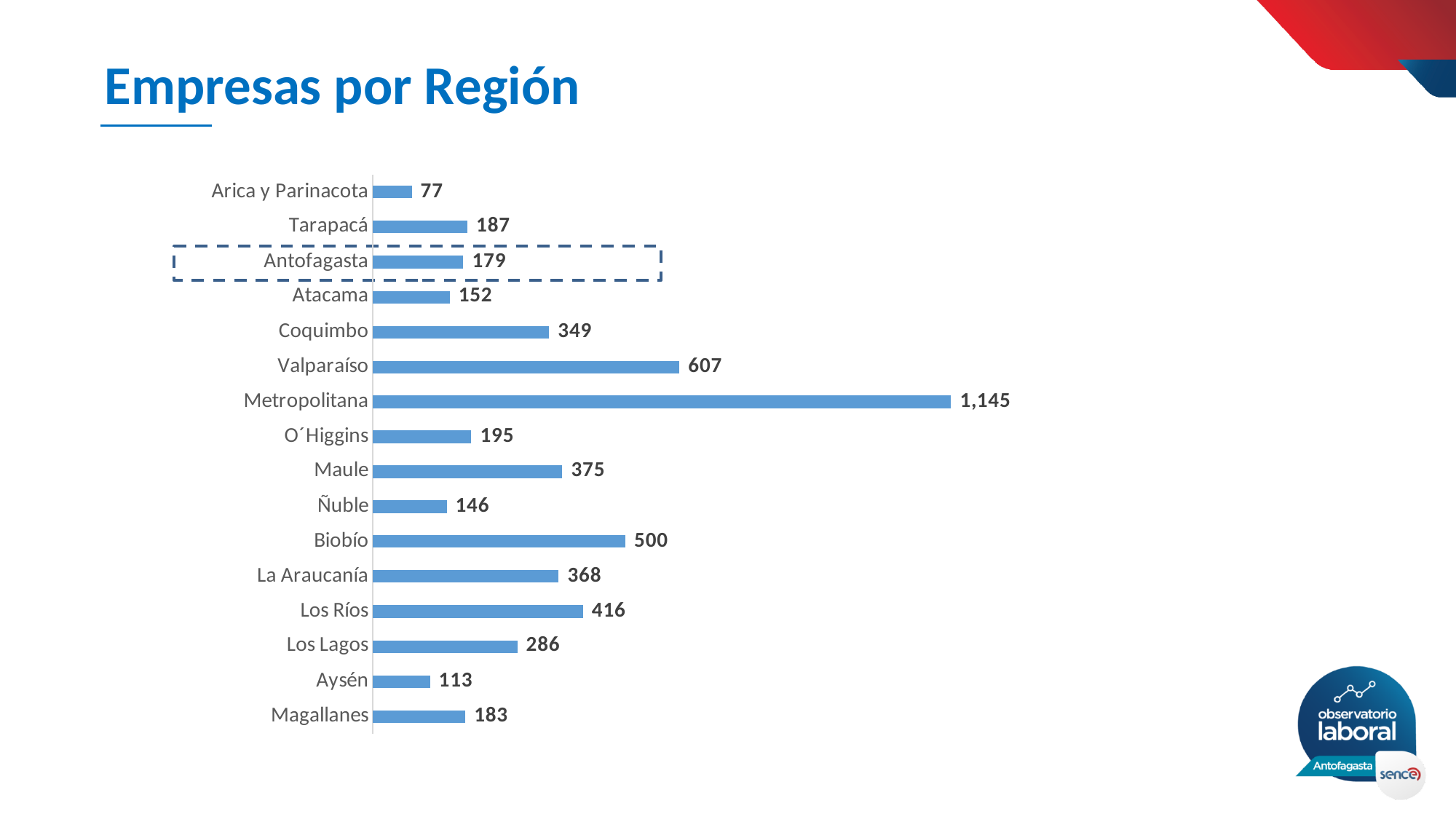
What kind of chart is shown on the slide? Bar chart What is the difference between the values for Tarapacá and Antofagasta? 8 Which region has the highest value? Metropolitana What is the difference between the values for Valparaíso and Biobío? 107 Which is larger, the value for Coquimbo or the value for Los Lagos? Coquimbo What is the value for Antofagasta? 179 How many regions are shown in the chart? 16 Which is larger, the value for Maule or the value for La Araucanía? Maule What is the value for Metropolitana? 1,145 Which region has the lowest value? Arica y Parinacota What is the value for Los Ríos? 416 What is the title of the slide? Empresas por Región